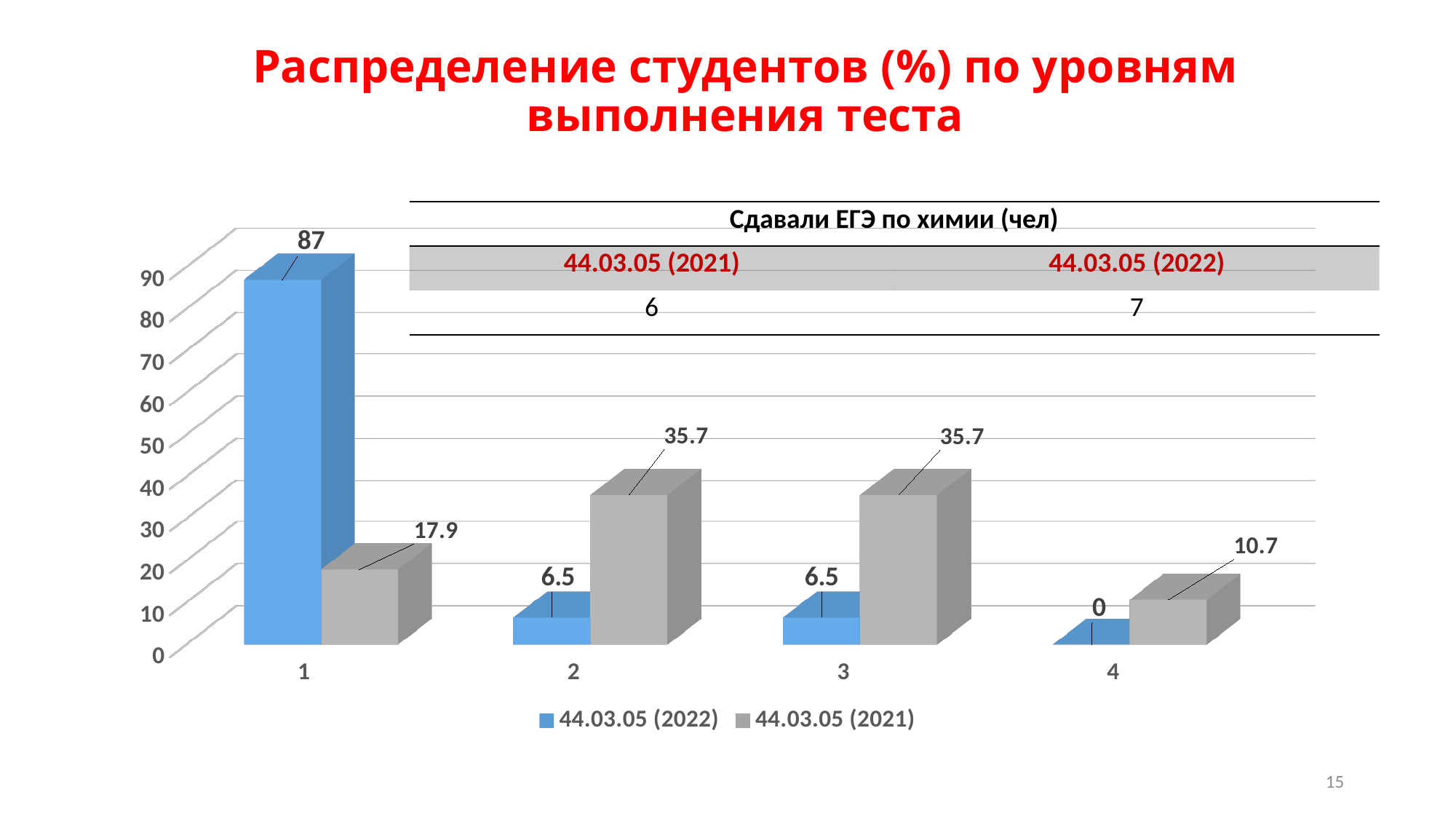
What is the value for category 1 in the 44.03.05 (2021) series? 17.9 Which colour represents the 44.03.05 (2022) series in the chart? blue What is the difference between the 44.03.05 (2022) and 44.03.05 (2021) values for category 1? 69.1 What kind of chart is shown on the slide? bar chart Which category has the lowest value in the 44.03.05 (2021) series? 4 What is the value for category 2 in the 44.03.05 (2022) series? 6.5 How many categories are shown on the x axis of the chart? 4 How many series does the chart legend list? 2 What is the value for category 4 in the 44.03.05 (2021) series? 10.7 Which category has the highest value in the 44.03.05 (2022) series? 1 What is the value for category 1 in the 44.03.05 (2022) series? 87 For category 2, which series has the larger value, 44.03.05 (2022) or 44.03.05 (2021)? 44.03.05 (2021)